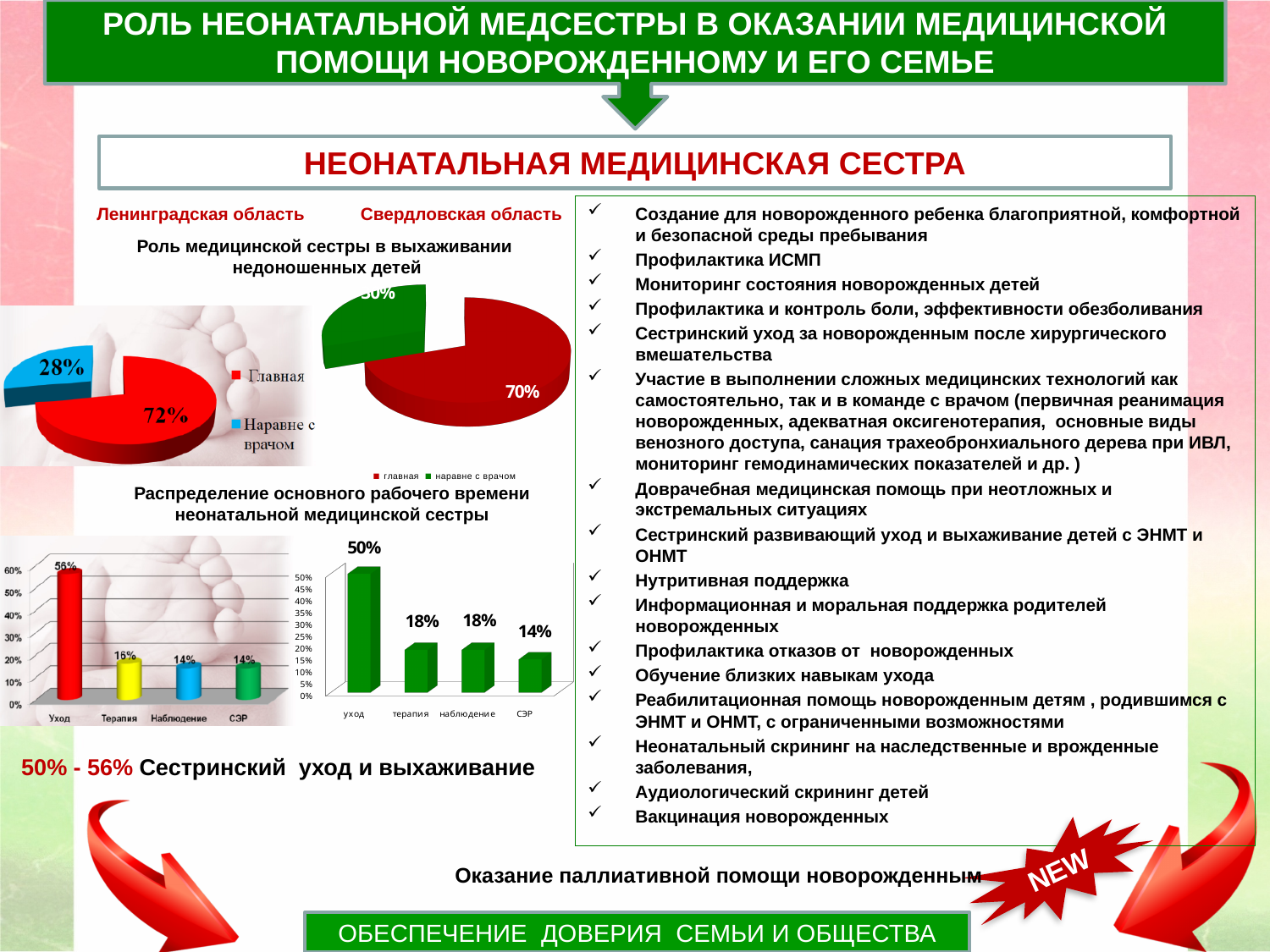
In the Sverdlovsk region bar chart on the distribution of working time, which category has the lowest value? СЭР In the Leningrad region pie chart on the role of the nurse, what is the difference between the 'Главная' and 'Наравне с врачом' shares? 44% In the Sverdlovsk region bar chart on the distribution of working time, what is the value for 'уход'? 50% In the Sverdlovsk region bar chart on the distribution of working time, what is the difference between 'уход' and 'СЭР'? 36% In the Leningrad region bar chart on the distribution of working time, what is the value for 'Терапия'? 16% What type of chart is used to show the distribution of the neonatal nurse's working time? Bar chart In the Sverdlovsk region bar chart on the distribution of working time, how many categories are shown? 4 In the Leningrad region pie chart on the role of the nurse in nursing premature infants, what share is labelled 'Главная'? 72% In the Leningrad region pie chart on the role of the nurse, what share is labelled 'Наравне с врачом'? 28% In the Sverdlovsk region pie chart on the role of the nurse, what share is labelled 'главная'? 70% In the Leningrad region pie chart on the role of the nurse, which slice is larger: 'Главная' or 'Наравне с врачом'? Главная In the Leningrad region bar chart on the distribution of working time, what is the value for 'Уход'? 56%